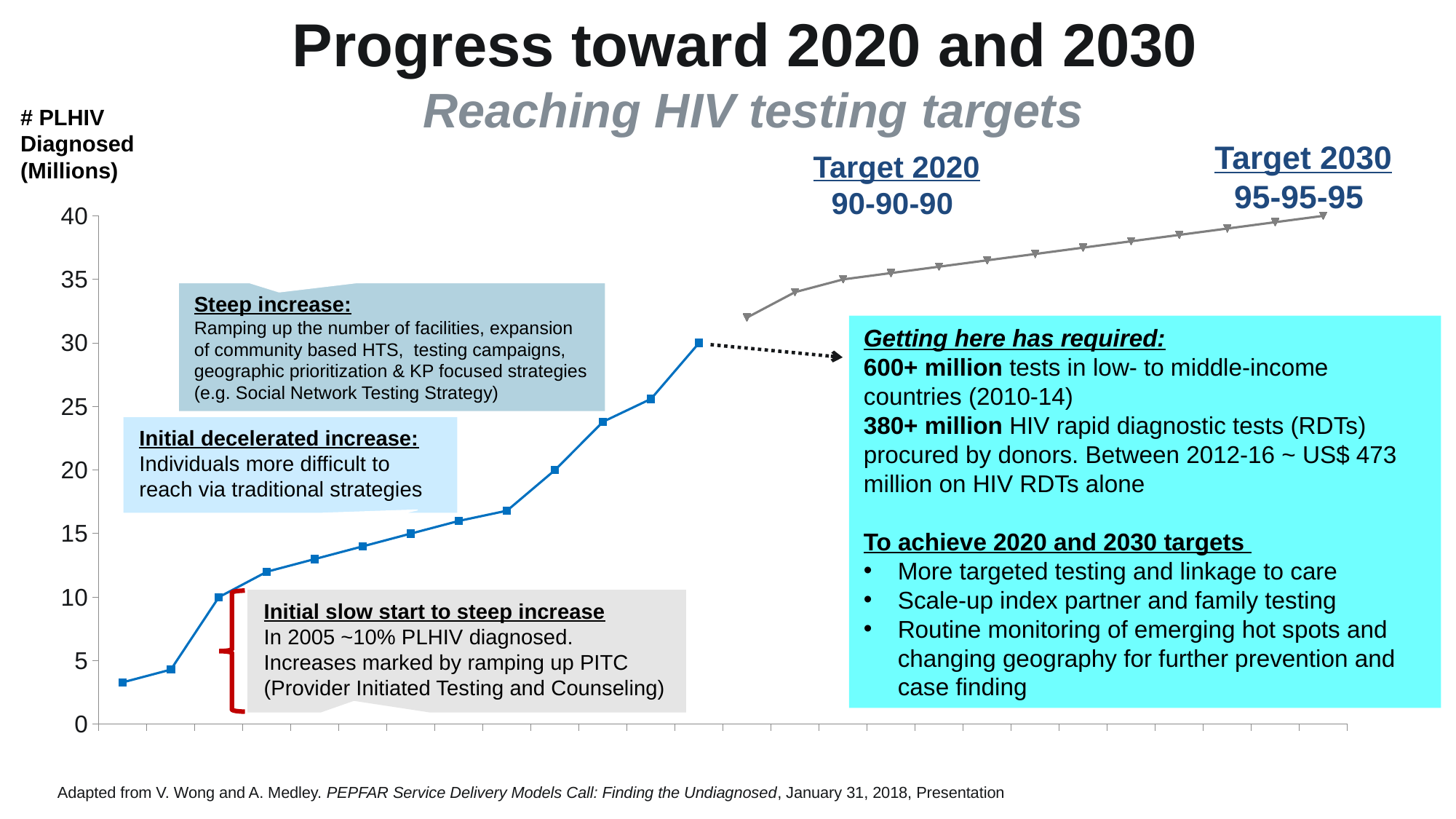
What target is written under 'Target 2020' above the chart? 90-90-90 What value does the gray target line reach at its right-hand end? 40 What type of chart is shown on the slide? line chart Does the blue line rise or fall from left to right? rise What is the label of the y axis? # PLHIV Diagnosed (Millions) Is the value of the first point on the gray target line greater or less than 30? greater Which is higher: the last point of the blue line or the first point of the gray target line? the first point of the gray target line Is the value of the first point on the blue line greater or less than 5? less How many lines are plotted on the chart? 2 What value does the last point of the blue line reach on the y axis? 30 Is the highest point of the blue line greater or less than 25? greater What is the difference between the end of the gray target line (40) and the last point of the blue line (30)? 10